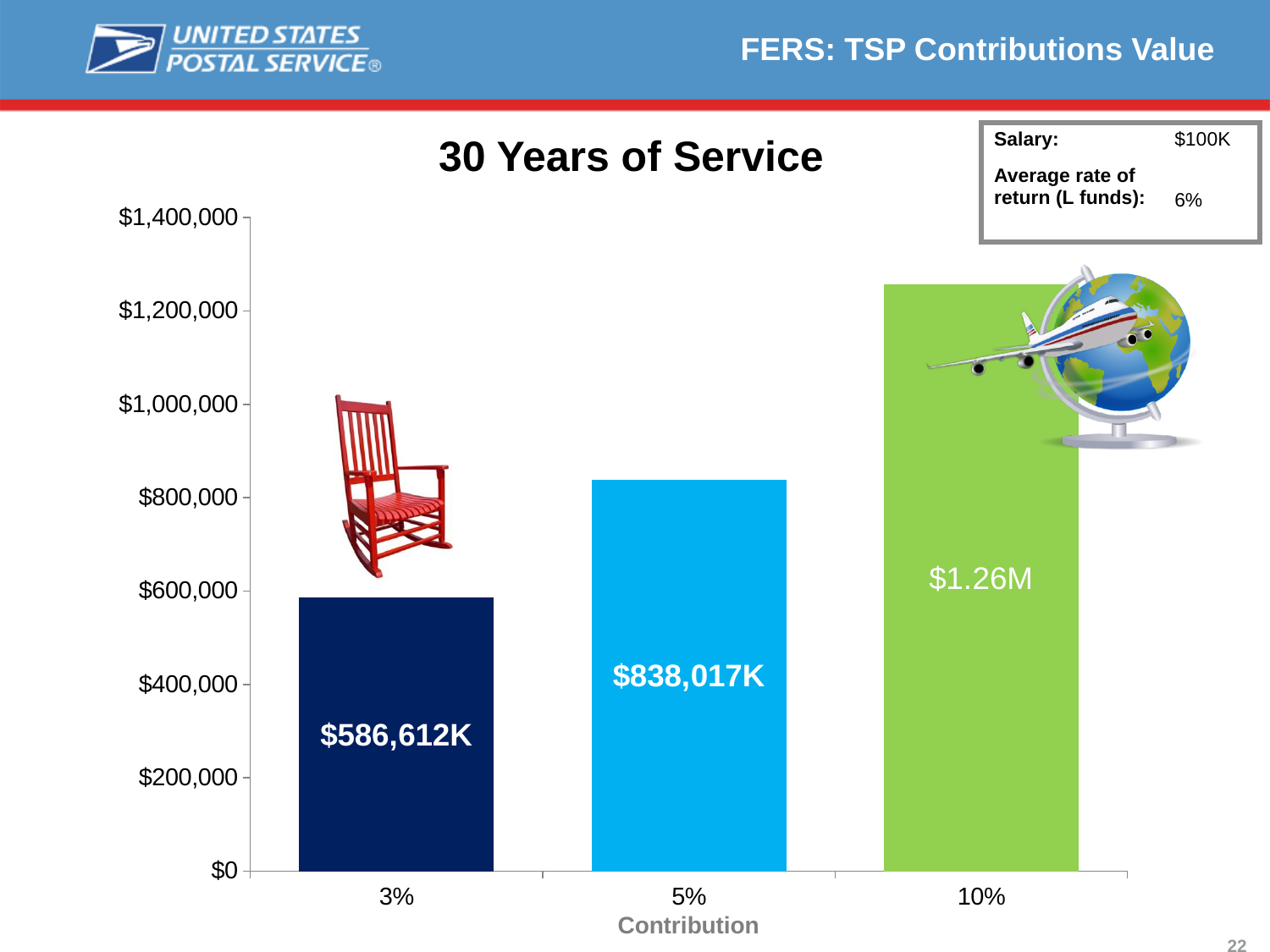
What kind of chart is shown on the slide? bar chart Is the value for the 3% contribution greater or less than $600,000? less How many contribution levels are shown on the chart? 3 Which has a larger value, the 5% contribution or the 3% contribution? 5% What is the title of the chart? 30 Years of Service What is the value shown for the 5% contribution bar? $838,017K What is the value shown for the 10% contribution bar? $1.26M Do the values rise or fall as the contribution percentage increases along the x axis? rise Which contribution level has the highest value? 10% Which contribution level has the lowest value? 3% What is the value shown for the 3% contribution bar? $586,612K Is the value for the 10% contribution greater or less than $1,200,000? greater